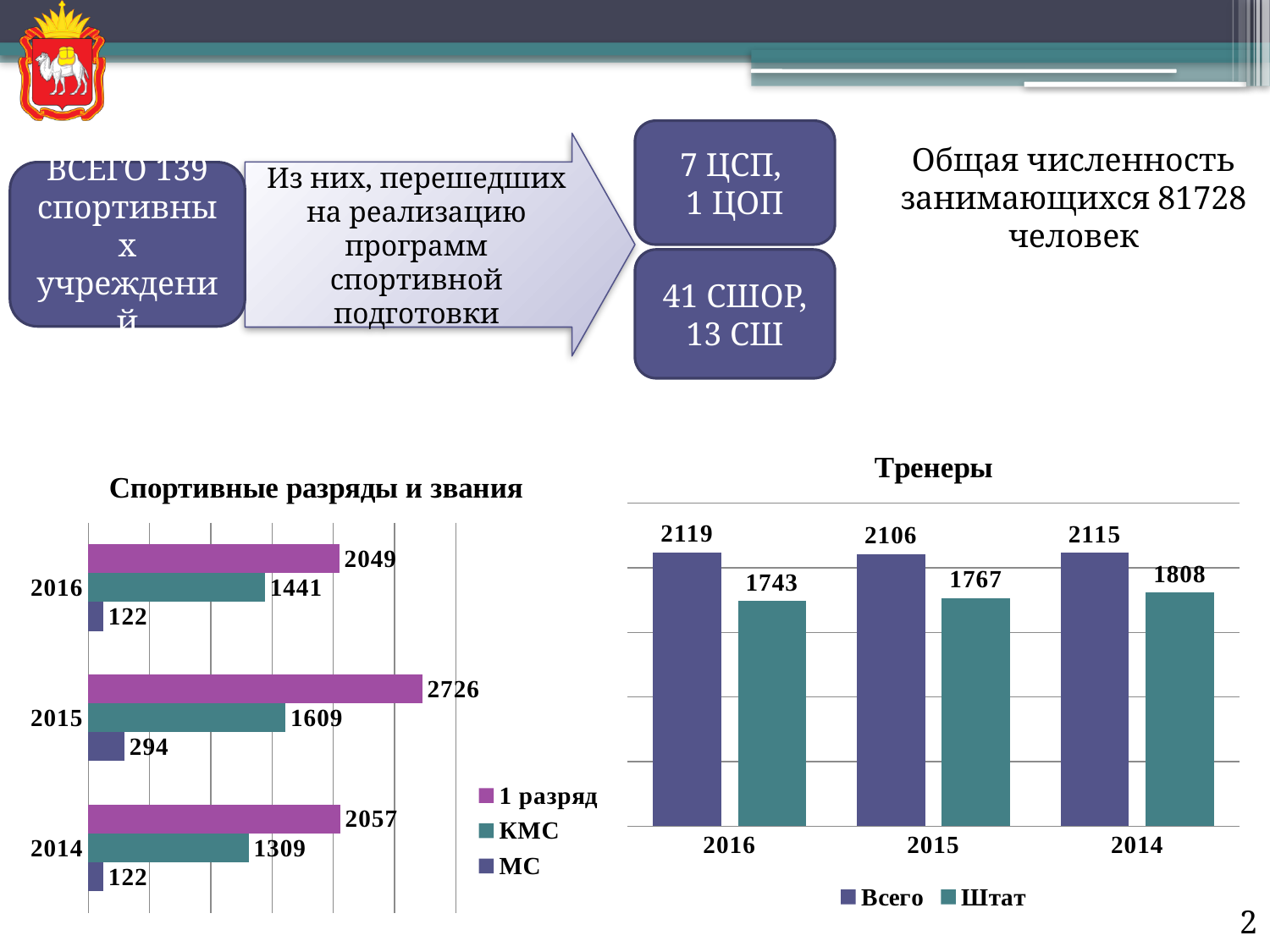
In the chart 'Спортивные разряды и звания', what is the value for '1 разряд' in 2015? 2726 In the chart 'Тренеры', what is the value for 'Штат' in 2015? 1767 In the chart 'Спортивные разряды и звания', what is the difference between the '1 разряд' values for 2015 and 2016? 677 In the chart 'Тренеры', what is the difference between 'Всего' and 'Штат' in 2014? 307 In the chart 'Спортивные разряды и звания', what is the value for 'КМС' in 2014? 1309 In the chart 'Тренеры', how many years are shown on the x axis? 3 In the chart 'Тренеры', which year has the lowest value for 'Штат'? 2016 In the chart 'Тренеры', what is the value for 'Всего' in 2016? 2119 In the chart 'Спортивные разряды и звания', how many series does the legend list? 3 In the chart 'Тренеры', which series is shown in the darker blue-purple colour? Всего What type of chart is 'Спортивные разряды и звания'? Bar chart In the chart 'Спортивные разряды и звания', which year has the highest value for 'МС'? 2015